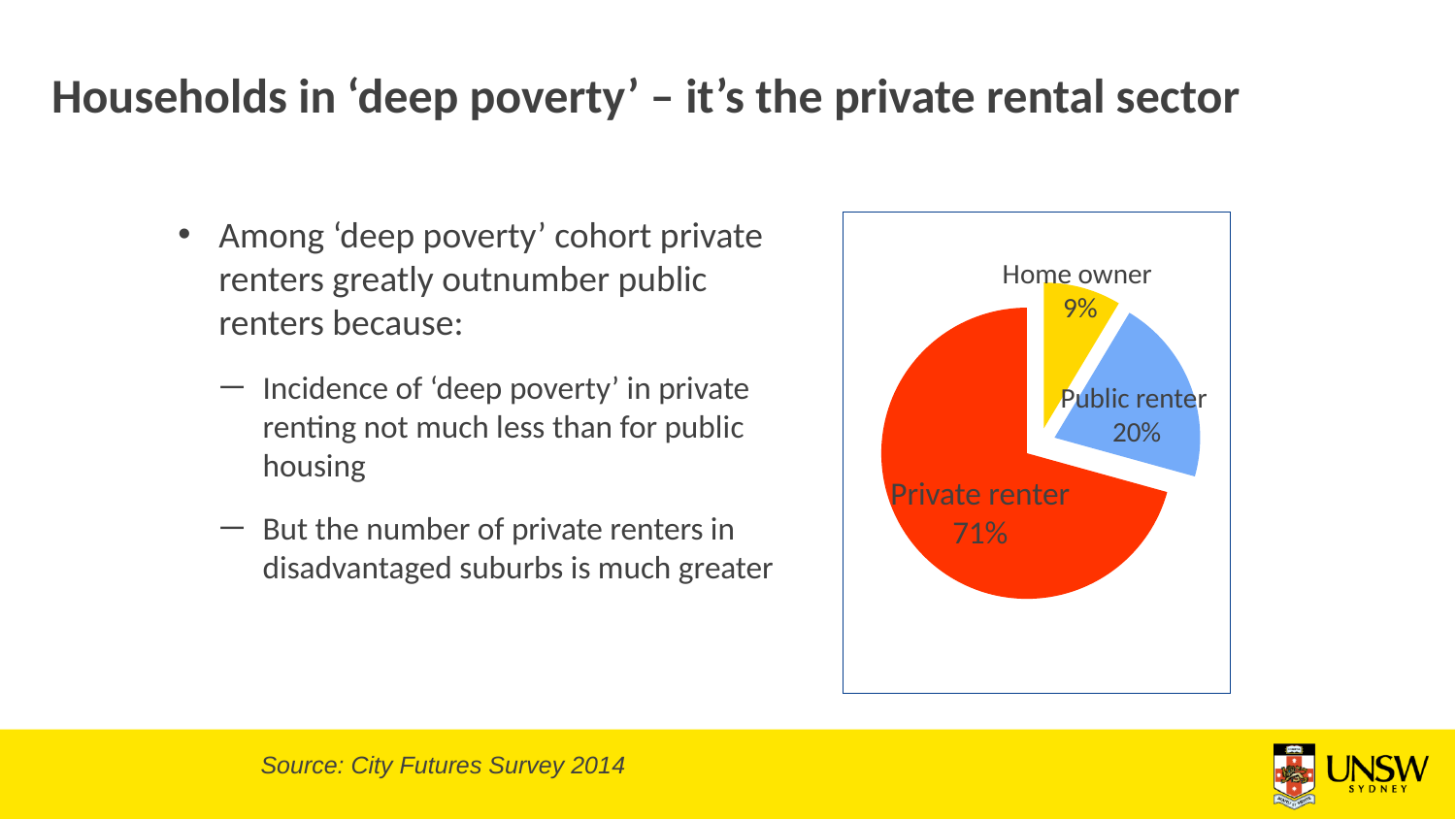
Which category has the smallest slice of the pie chart? Home owner What is the difference in percentage points between the Public renter and Home owner slices? 11 Which category has the largest slice of the pie chart? Private renter What colour is the Private renter slice of the pie chart? Red What colour is the Home owner slice of the pie chart? Yellow What is the difference in percentage points between the Private renter and Public renter slices? 51 What share of the pie chart is Private renter? 71% How many categories are shown in the pie chart? 3 What share of the pie chart is Home owner? 9% What share of the pie chart is Public renter? 20% What kind of chart is shown on the slide? Pie chart Which is larger, the Public renter slice or the Home owner slice? Public renter